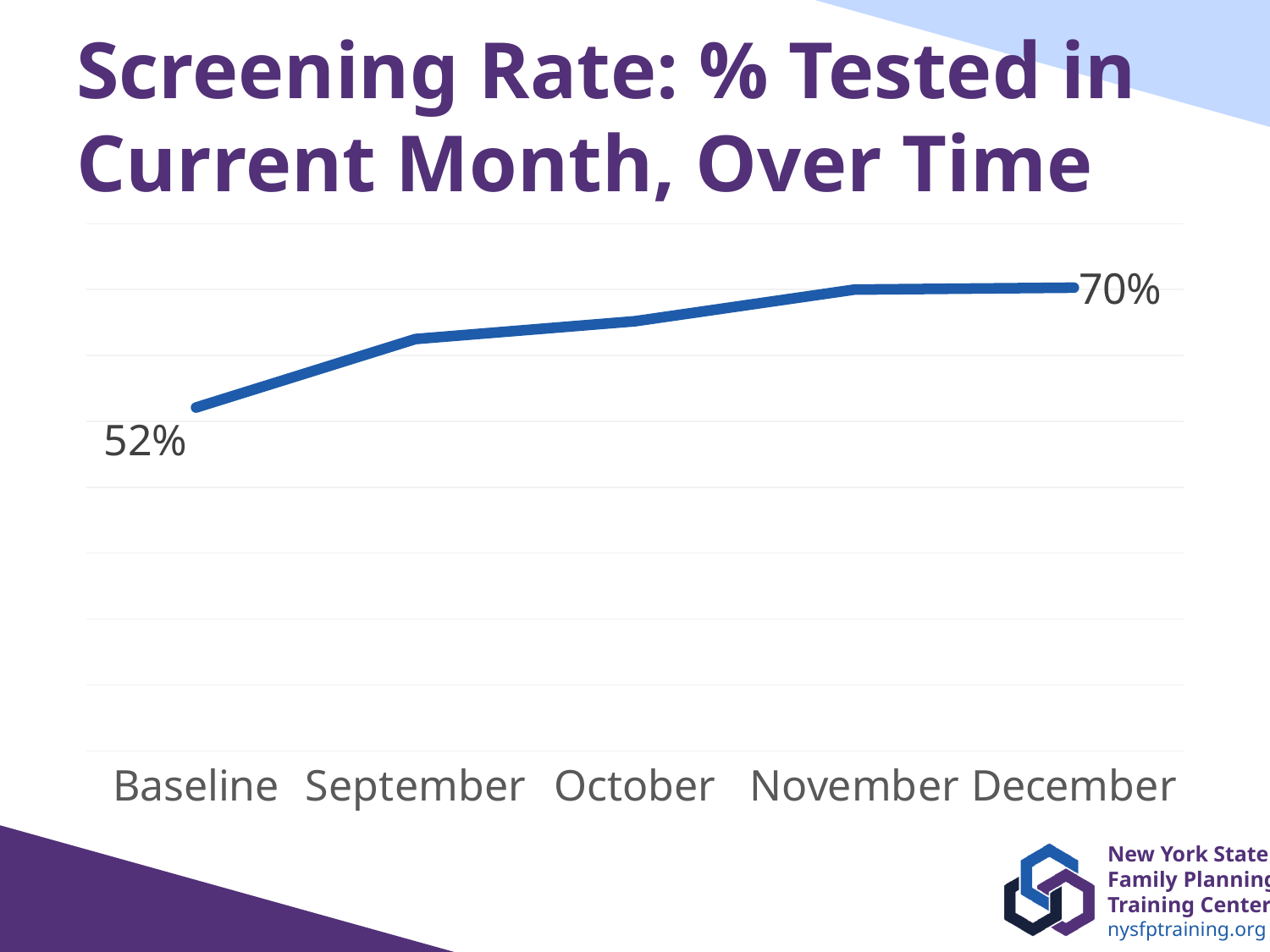
Is the screening rate higher in October or in December? December What is the screening rate at Baseline? 52% By how many percentage points did the screening rate increase from Baseline to December? 18% Which time point has the lowest screening rate? Baseline Is the screening rate higher at Baseline or in September? September What is the last time point labeled on the x axis? December What kind of chart is shown on the slide? Line chart What is the title of the chart on the slide? Screening Rate: % Tested in Current Month, Over Time Does the screening rate rise or fall from Baseline to December? Rise What is the screening rate in December? 70% Is the screening rate higher at Baseline or in December? December How many time points are plotted on the chart? 5